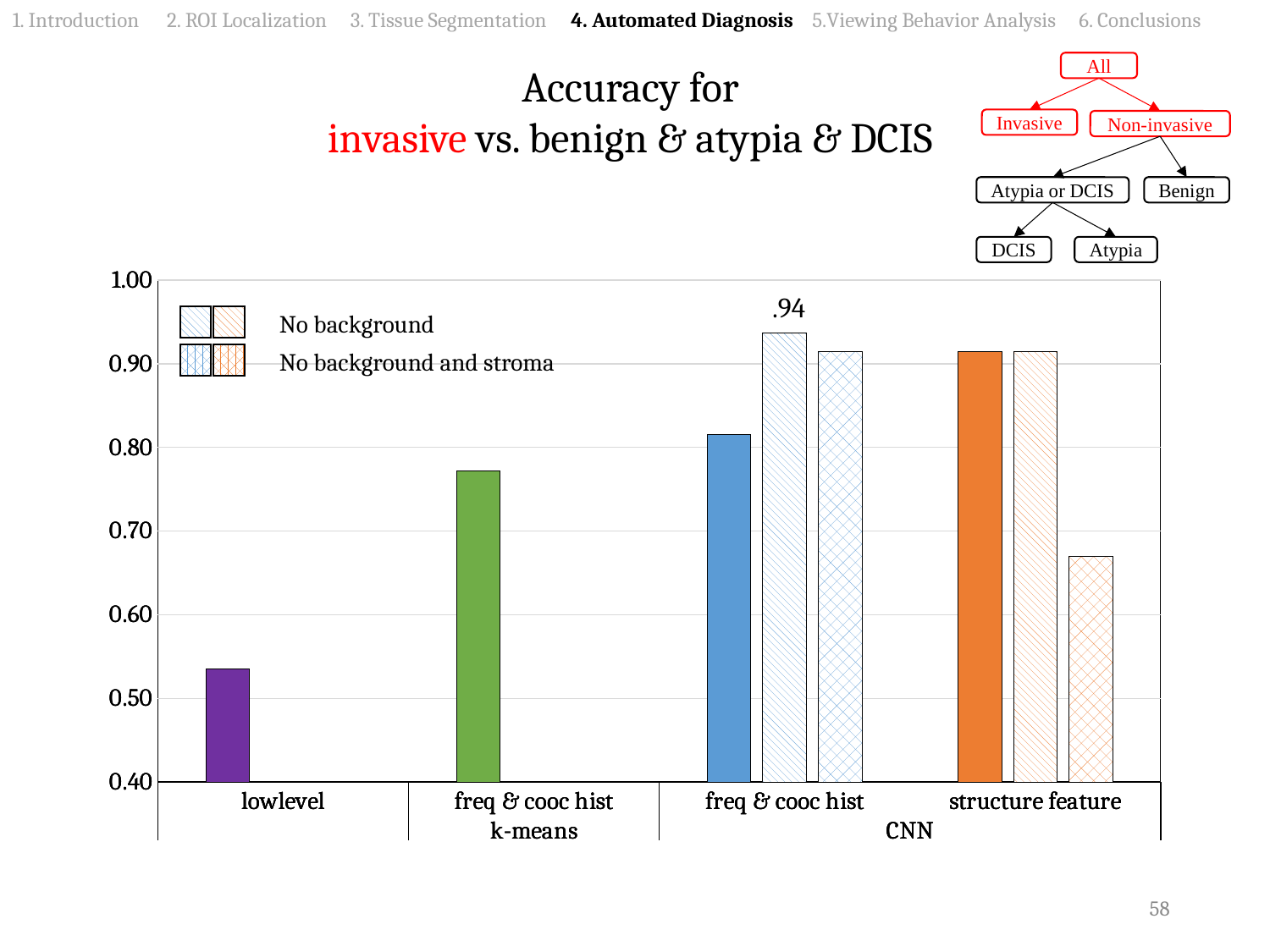
What kind of chart is shown on the slide? bar chart How many entries does the legend list? 2 What are the two entries listed in the legend? No background; No background and stroma Is the 'No background and stroma' bar for structure feature greater or less than 0.70? less What is the value printed as a data label on the chart? .94 Which is larger: the bar for lowlevel or the bar for freq & cooc hist under k-means? freq & cooc hist under k-means Is the value for lowlevel greater or less than 0.60? less How many categories are shown along the x axis? 4 Which category contains the tallest bar in the chart? freq & cooc hist (CNN) Which category has the lowest bar in the chart? lowlevel Is the value for freq & cooc hist under k-means greater or less than 0.80? less